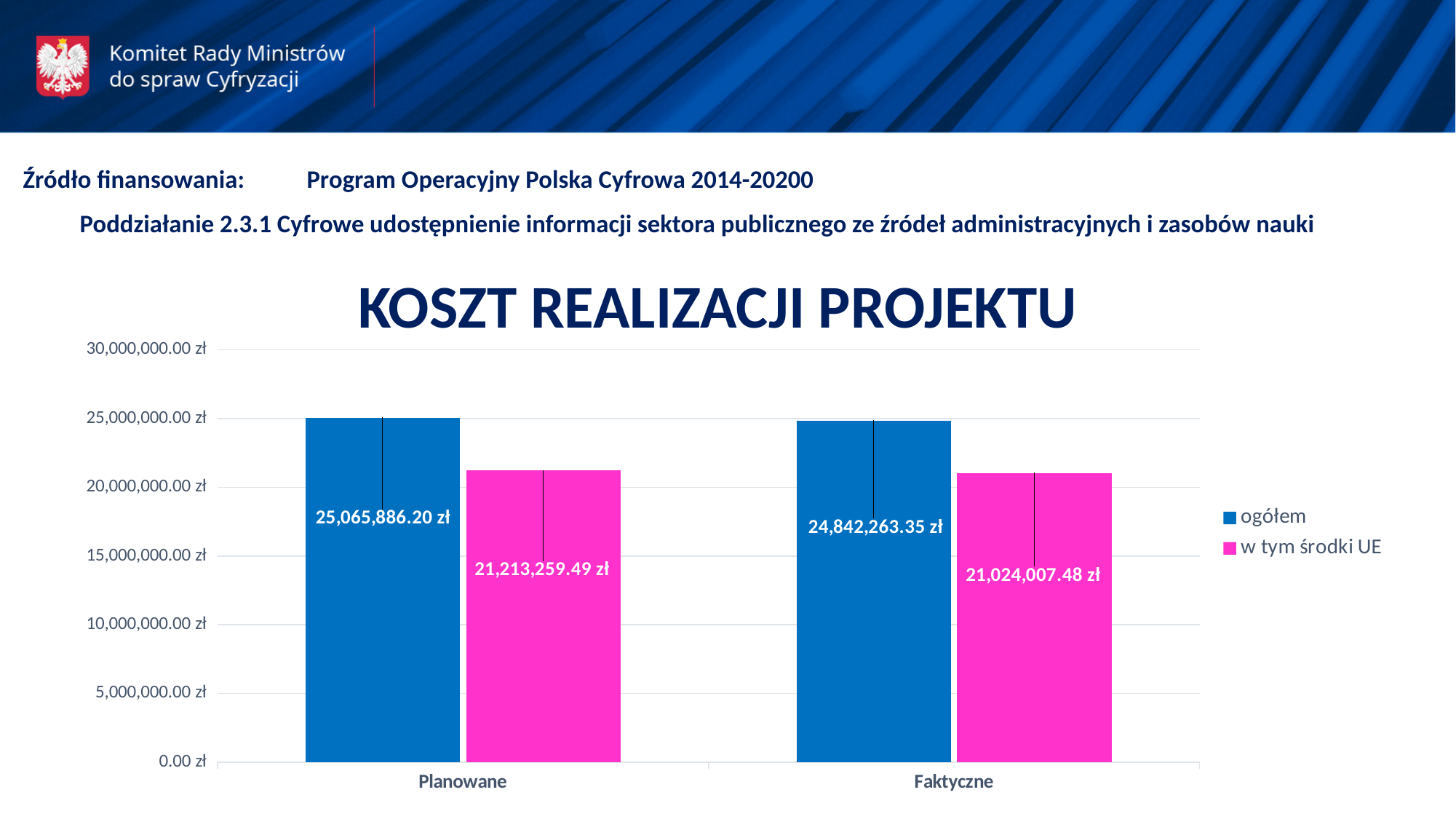
What is the title of the chart? KOSZT REALIZACJI PROJEKTU What is the value of ogółem for Planowane? 25,065,886.20 zł What is the value of w tym środki UE for Faktyczne? 21,024,007.48 zł What is the difference between the ogółem values for Planowane and Faktyczne? 223,622.85 zł What is the value of w tym środki UE for Planowane? 21,213,259.49 zł Which bar has the highest value in the chart? ogółem for Planowane What is the difference between ogółem and w tym środki UE for Faktyczne? 3,818,255.87 zł How many series does the legend list? 2 How many categories are shown on the x axis? 2 What is the value of ogółem for Faktyczne? 24,842,263.35 zł Is the ogółem value for Faktyczne greater or less than 25,000,000.00 zł? less Which bar has the lowest value in the chart? w tym środki UE for Faktyczne